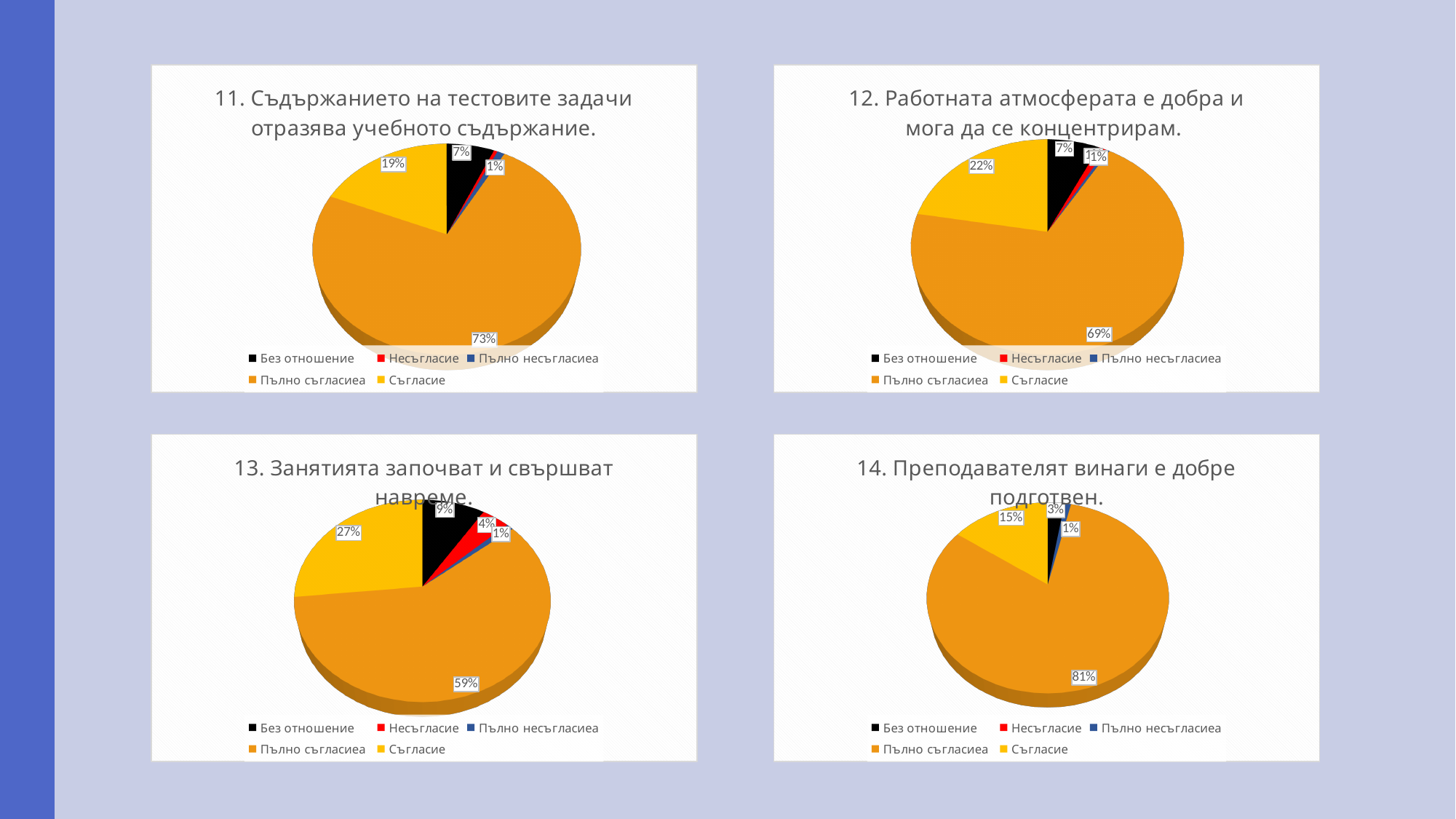
How many entries does the legend of the chart titled "14. Преподавателят винаги е добре подготвен." list? 5 What type of chart is the chart titled "11. Съдържанието на тестовите задачи отразява учебното съдържание."? Pie chart In the chart titled "11. Съдържанието на тестовите задачи отразява учебното съдържание.", what share is labelled for Съгласие? 19% In the chart titled "14. Преподавателят винаги е добре подготвен.", which category has the largest slice? Пълно съгласиеа In the chart titled "13. Занятията започват и свършват навреме.", what is the difference between the Пълно съгласиеа share and the Съгласие share? 32% In the chart titled "12. Работната атмосферата е добра и мога да се концентрирам.", what share is labelled for Пълно съгласиеа? 69% In the chart titled "13. Занятията започват и свършват навреме.", what share is labelled for Несъгласие? 4% In the chart titled "12. Работната атмосферата е добра и мога да се концентрирам.", what share is labelled for Без отношение? 7% In the chart titled "11. Съдържанието на тестовите задачи отразява учебното съдържание.", what share is labelled for Пълно съгласиеа? 73% In the chart titled "14. Преподавателят винаги е добре подготвен.", what share is labelled for Пълно съгласиеа? 81% In the chart titled "13. Занятията започват и свършват навреме.", what share is labelled for Съгласие? 27% In the chart titled "12. Работната атмосферата е добра и мога да се концентрирам.", which is larger, the Съгласие share or the Без отношение share? Съгласие